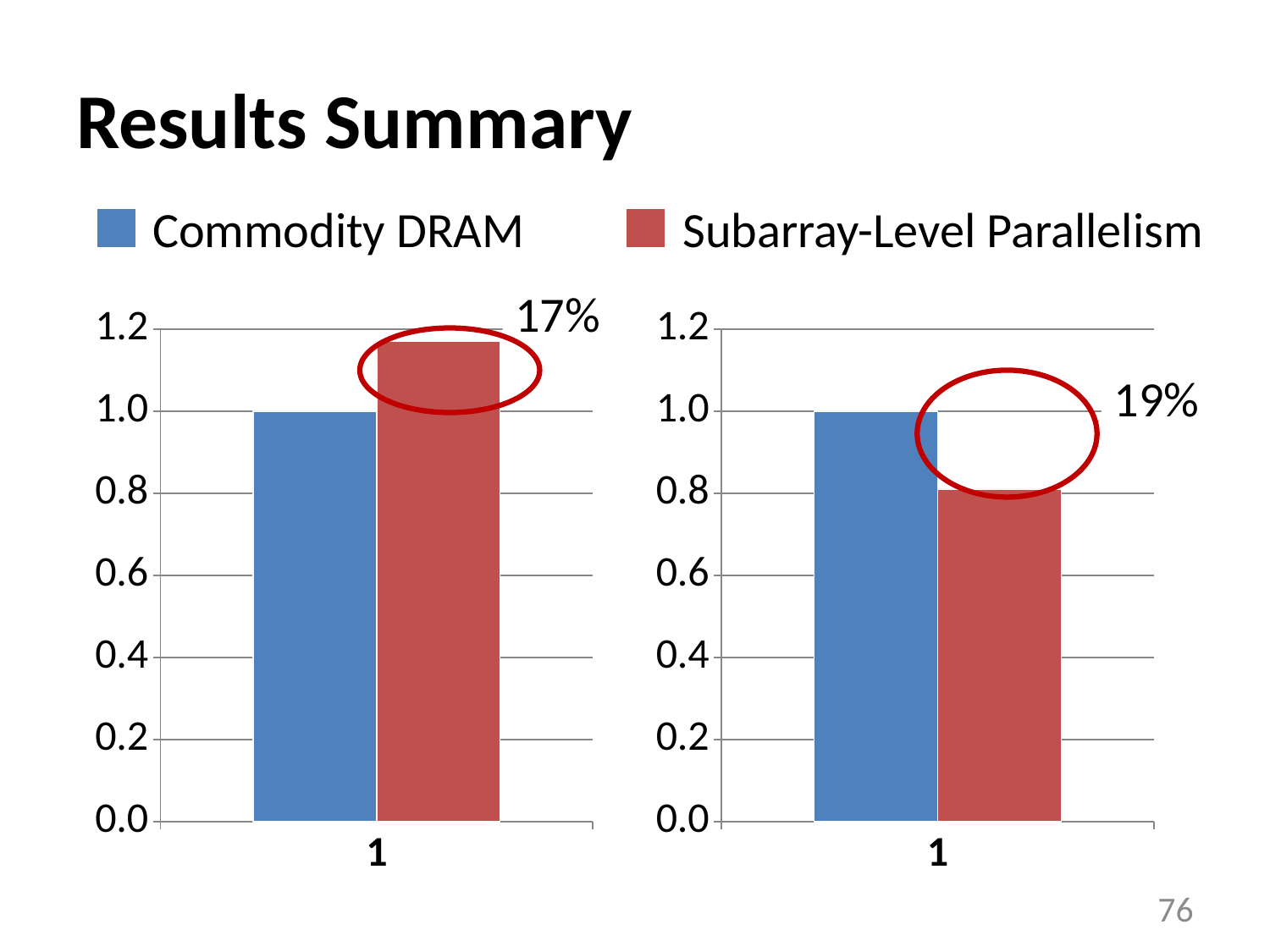
How many series does the legend list? 2 What kind of chart is the left chart on the slide? bar chart In the right chart, what is the value for Commodity DRAM? 1.0 In the right chart, which series has the lower bar, Commodity DRAM or Subarray-Level Parallelism? Subarray-Level Parallelism In the left chart, what is the value for Commodity DRAM? 1.0 Which colour represents Subarray-Level Parallelism in the legend? red In the left chart, is the value for Subarray-Level Parallelism greater or less than 1.0? greater In the right chart, is the value for Subarray-Level Parallelism greater or less than 1.0? less In the right chart, is the value for Subarray-Level Parallelism greater or less than 0.6? greater What percentage is annotated next to the circled bar in the left chart? 17% In the left chart, which series has the higher bar, Commodity DRAM or Subarray-Level Parallelism? Subarray-Level Parallelism